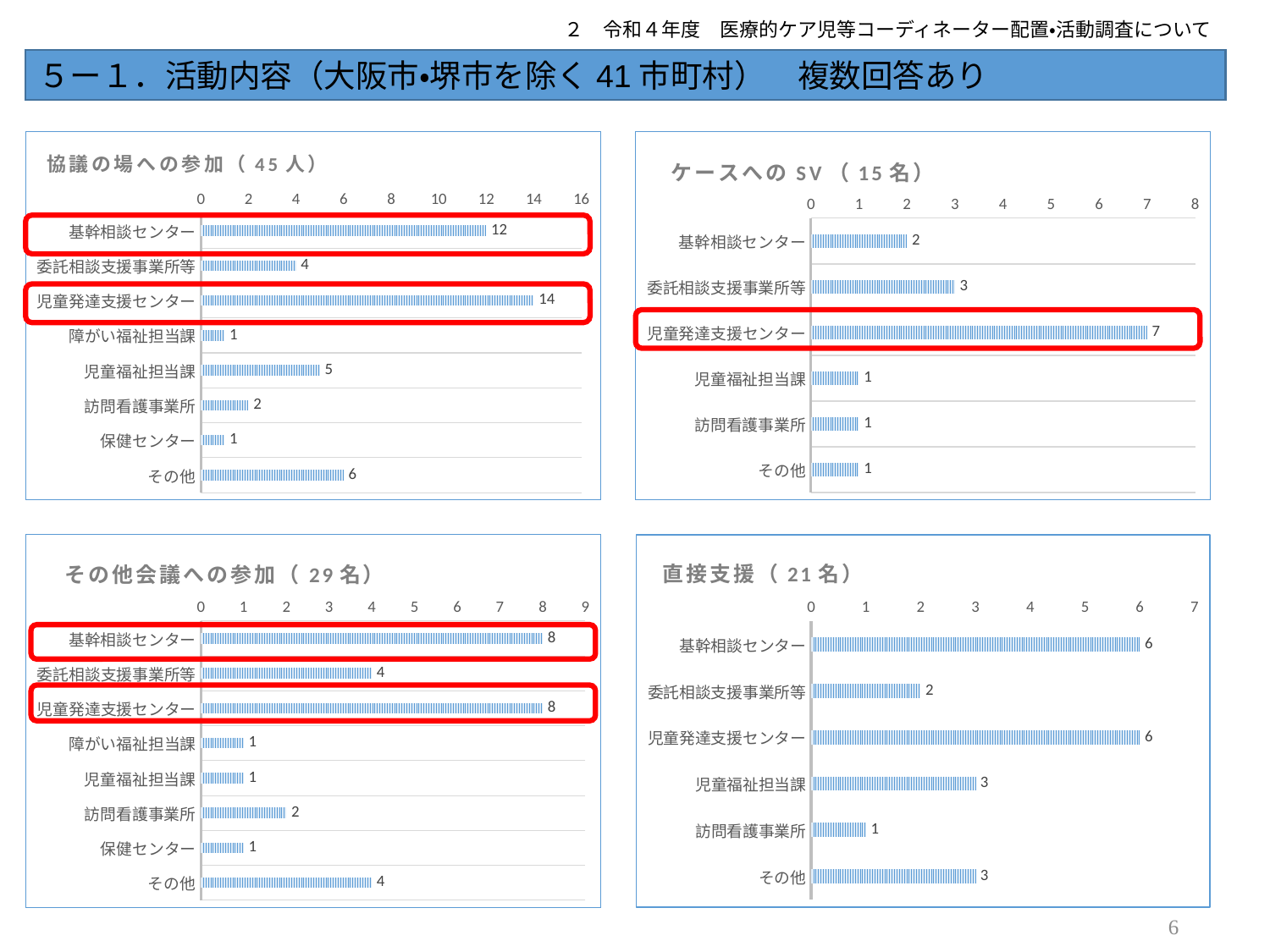
In the chart titled 直接支援（21名）, what is the value for 児童福祉担当課? 3 In the chart titled その他会議への参加（29名）, what is the difference between the values for 基幹相談センター and 委託相談支援事業所等? 4 In the chart titled ケースへのSV（15名）, which is larger, the value for 基幹相談センター or the value for 委託相談支援事業所等? 委託相談支援事業所等 What type of chart is the chart titled 直接支援（21名）? Bar chart In the chart titled その他会議への参加（29名）, what is the value for その他? 4 In the chart titled その他会議への参加（29名）, how many categories are shown? 8 In the chart titled 協議の場への参加（45人）, which category has the highest value? 児童発達支援センター In the chart titled 協議の場への参加（45人）, what is the value for 基幹相談センター? 12 In the chart titled 直接支援（21名）, which category has the lowest value? 訪問看護事業所 In the chart titled 協議の場への参加（45人）, what is the difference between the values for 児童発達支援センター and 基幹相談センター? 2 In the chart titled ケースへのSV（15名）, how many categories are shown? 6 In the chart titled ケースへのSV（15名）, what is the value for 児童発達支援センター? 7